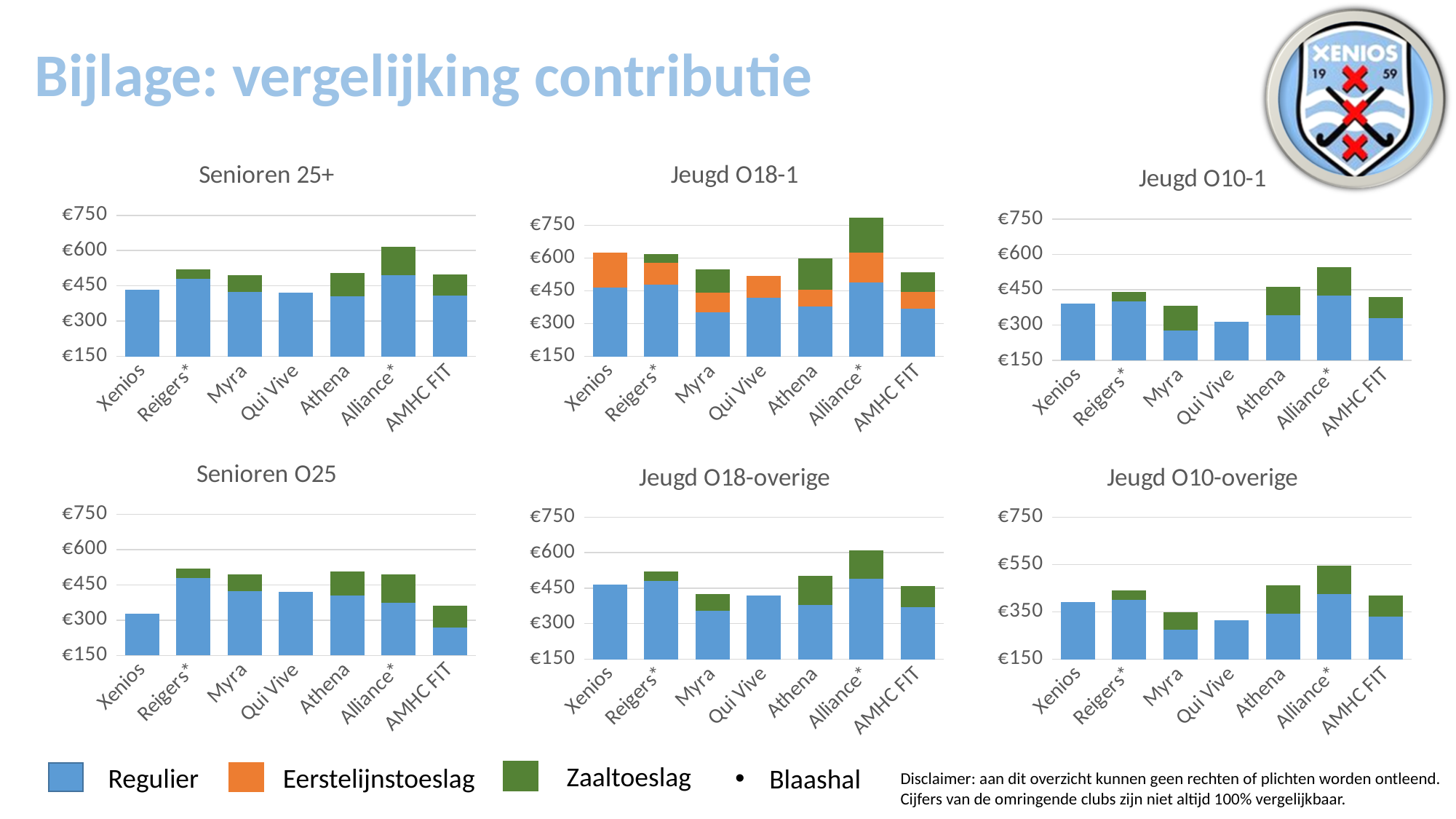
In the 'Senioren O25' chart, is the value for Xenios greater or less than €450? less In the 'Senioren 25+' chart, which is larger: the total for Alliance* or the total for Xenios? Alliance* In the 'Jeugd O10-1' chart, which club has the highest total contribution? Alliance* In the 'Jeugd O10-1' chart, which club has the lowest total contribution? Qui Vive In the 'Jeugd O18-1' chart, is the total for Alliance* greater or less than €750? greater What kind of chart is the 'Senioren 25+' chart? Stacked bar chart In the 'Jeugd O10-overige' chart, is the value for Qui Vive greater or less than €350? less How many series does the legend at the bottom of the slide list? 3 In the 'Senioren 25+' chart, which club has the highest total contribution? Alliance* In the 'Jeugd O18-overige' chart, which club has the highest total contribution? Alliance* Which legend entry is shown in orange? Eerstelijnstoeslag How many clubs are shown on the x axis of the 'Jeugd O18-1' chart? 7